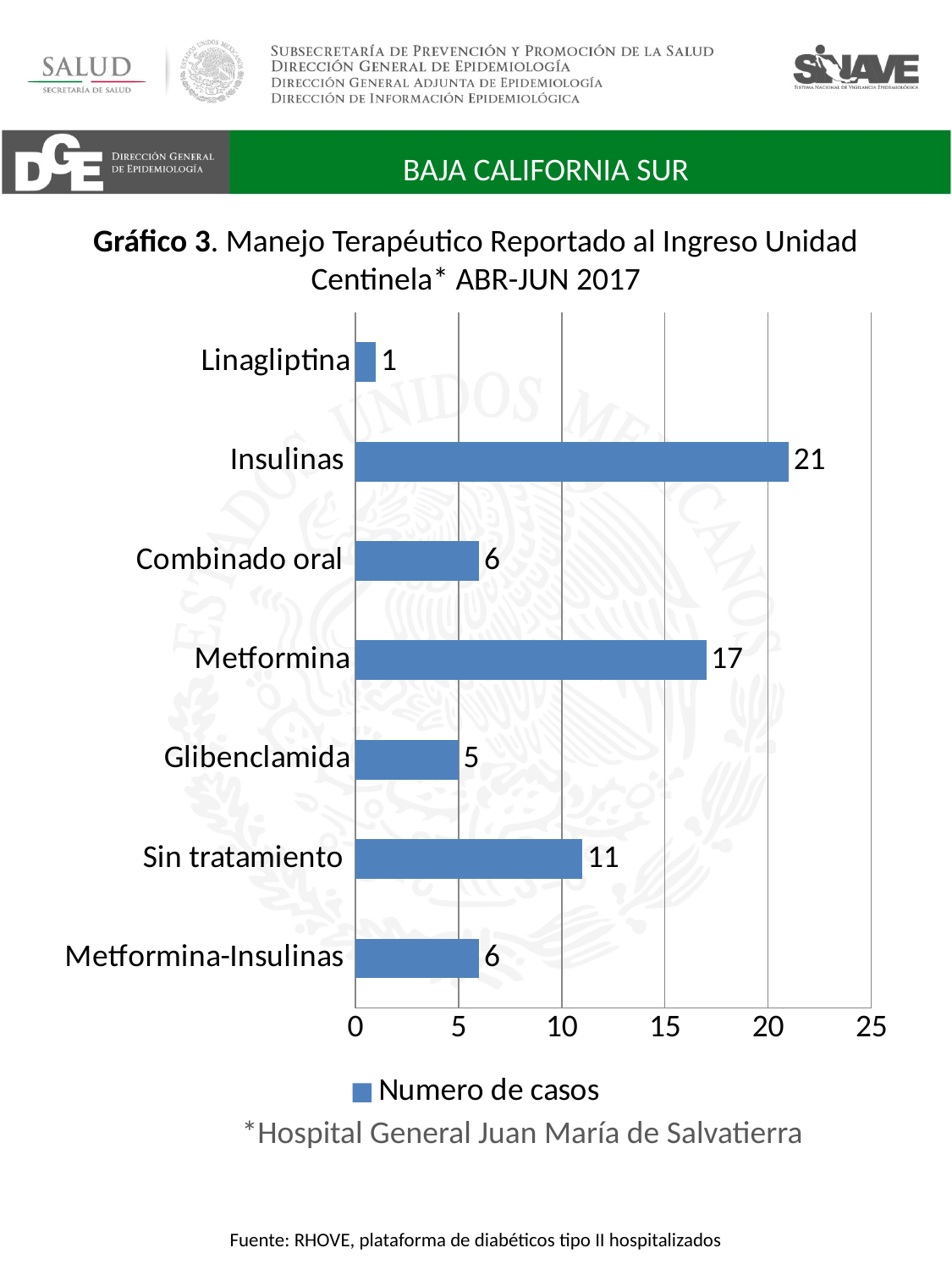
What is the number of cases for Insulinas? 21 What is the number of cases for Linagliptina? 1 How many series does the legend list? 1 What kind of chart is shown on the slide? Bar chart What is the number of cases for Sin tratamiento? 11 What is the difference in number of cases between Insulinas and Metformina? 4 How many categories are shown in the chart? 7 What is the legend entry of the chart? Numero de casos Which has more cases, Glibenclamida or Sin tratamiento? Sin tratamiento Which category has the lowest number of cases? Linagliptina Which category has the highest number of cases? Insulinas What is the number of cases for Metformina? 17